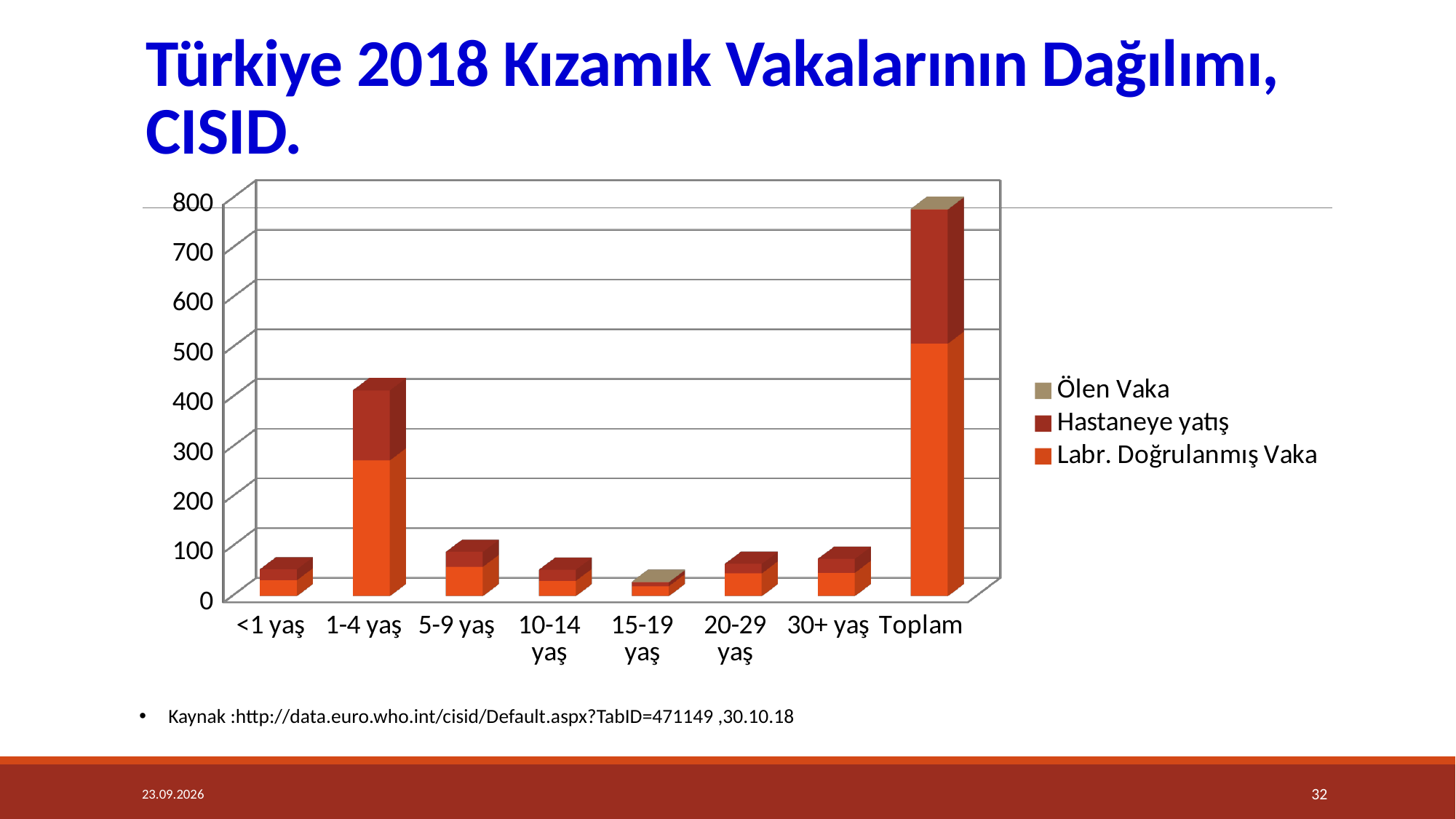
Which series is shown in the legend with the tan/beige colour? Ölen Vaka Among the age-group categories (excluding Toplam), which has the tallest bar? 1-4 yaş Which category has the tallest bar in the chart? Toplam Is the total bar height for 1-4 yaş greater or less than 300? greater What kind of chart is shown on the slide? Stacked bar chart Is the total bar height for 1-4 yaş greater or less than 500? less Is the total bar height for 5-9 yaş greater or less than 200? less How many series does the chart legend list? 3 How many categories are shown on the x axis of the chart? 8 Which bar is taller, 1-4 yaş or 5-9 yaş? 1-4 yaş What is the title of the slide containing the chart? Türkiye 2018 Kızamık Vakalarının Dağılımı, CISID.